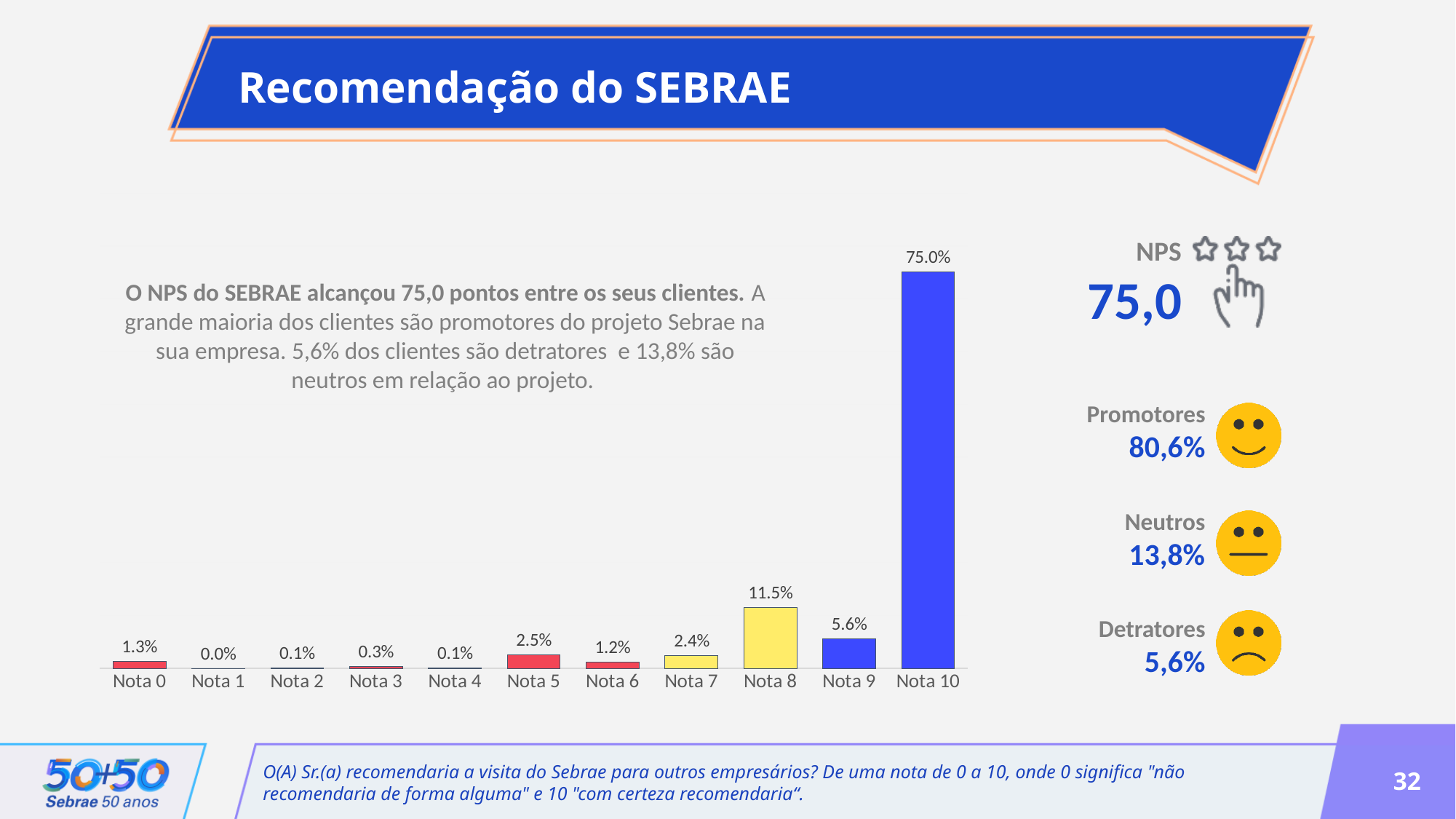
What colour is the bar for Nota 10? Blue What is the value for Nota 10? 75.0% What is the value for Nota 8? 11.5% What is the difference between the values for Nota 10 and Nota 8? 63.5% What kind of chart is shown on the slide? Bar chart What is the difference between the values for Nota 8 and Nota 9? 5.9% Which category has the highest value? Nota 10 Which category has the lowest value? Nota 1 What is the value for Nota 0? 1.3% How many categories are shown on the x axis of the chart? 11 What is the value for Nota 9? 5.6% Which is larger, the value for Nota 5 or the value for Nota 7? Nota 5